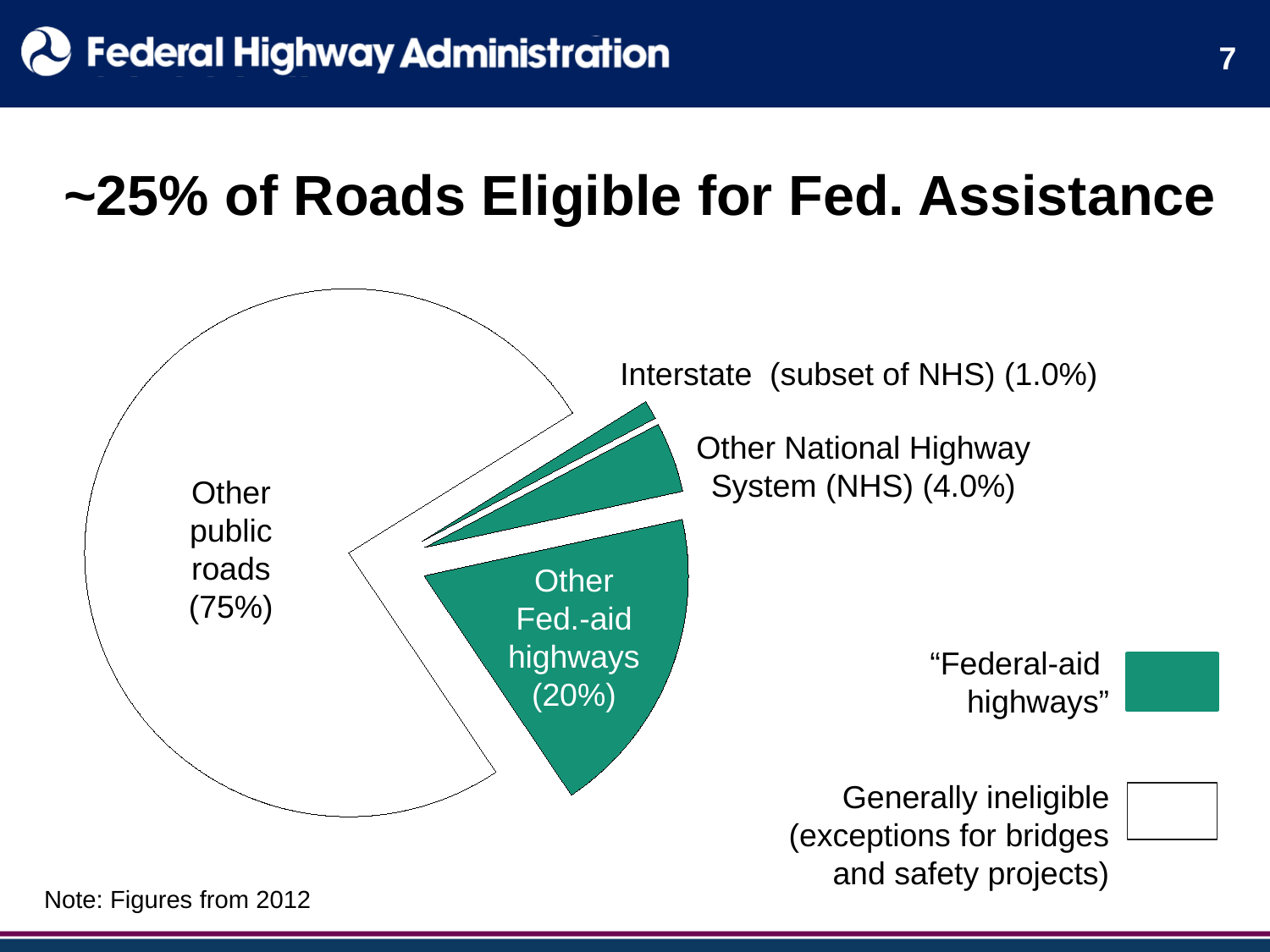
What is the combined share of the three green slices (Federal-aid highways)? 25% What share of roads is labelled as Other Fed.-aid highways? 20% Which is larger, the Other National Highway System (NHS) slice or the Interstate slice? Other National Highway System (NHS) What share of roads is labelled as Other National Highway System (NHS)? 4.0% Which slice of the pie is the smallest? Interstate (subset of NHS) Which slice of the pie is the largest? Other public roads What is the title of the slide above the chart? ~25% of Roads Eligible for Fed. Assistance What share of roads is labelled as Interstate (subset of NHS)? 1.0% How many slices does the pie chart have? 4 What is the difference in percentage points between Other public roads and Other Fed.-aid highways? 55 What kind of chart is shown on the slide? Pie chart What share of roads is labelled as Other public roads? 75%